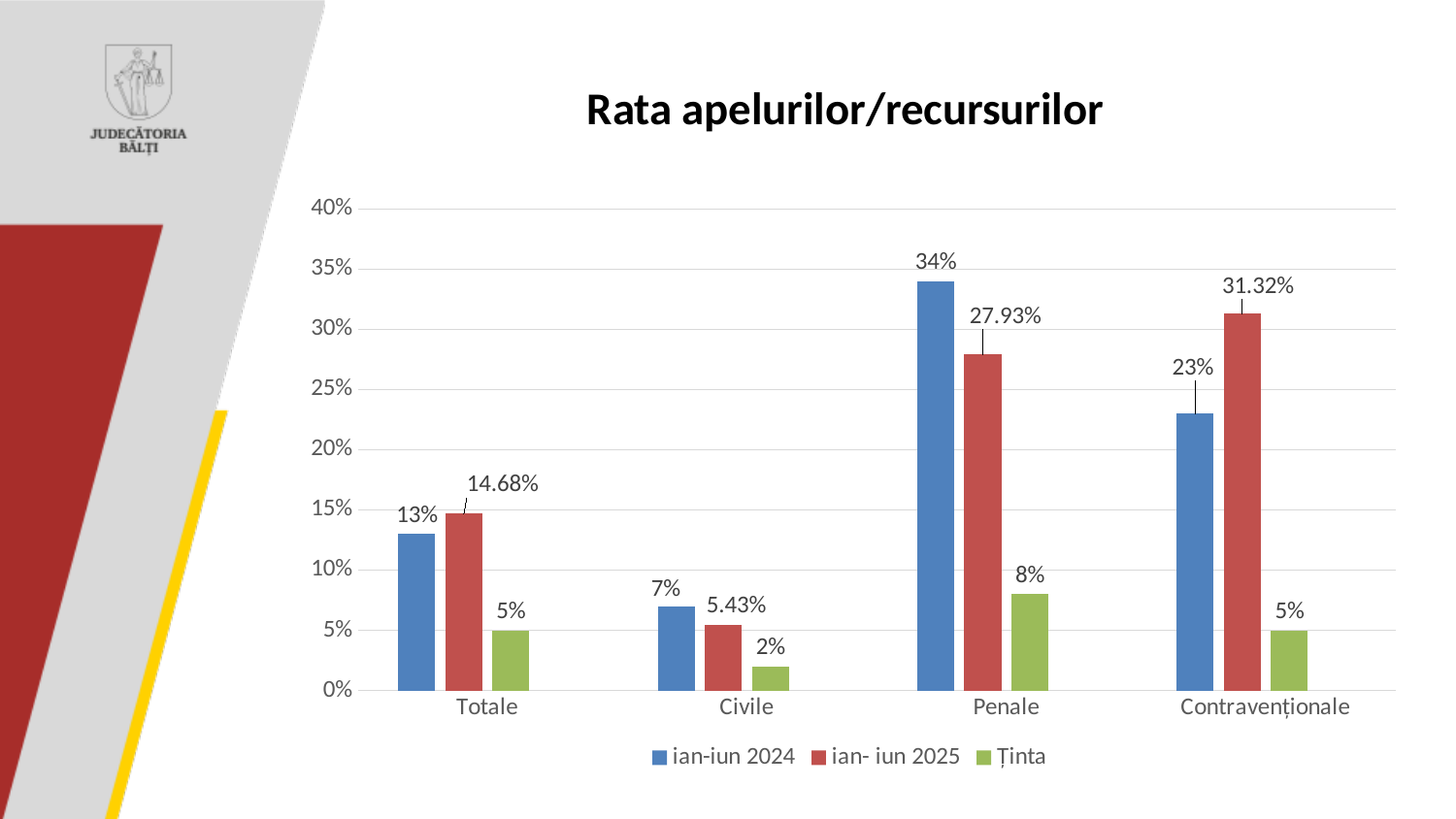
What is the title of the chart? Rata apelurilor/recursurilor What kind of chart is shown on the slide? bar chart For Contravenționale, which is larger: the ian-iun 2024 value or the ian- iun 2025 value? ian- iun 2025 Which category has the highest value in the ian-iun 2024 series? Penale What is the Ținta value for Civile? 2% How many categories are shown on the x axis? 4 What is the value for Contravenționale in the ian- iun 2025 series? 31.32% What is the value for Totale in the ian- iun 2025 series? 14.68% Which category has the lowest value in the ian- iun 2025 series? Civile How many series does the legend list? 3 What is the value for Penale in the ian-iun 2024 series? 34% What is the difference between the ian-iun 2024 and ian- iun 2025 values for Penale? 6.07%